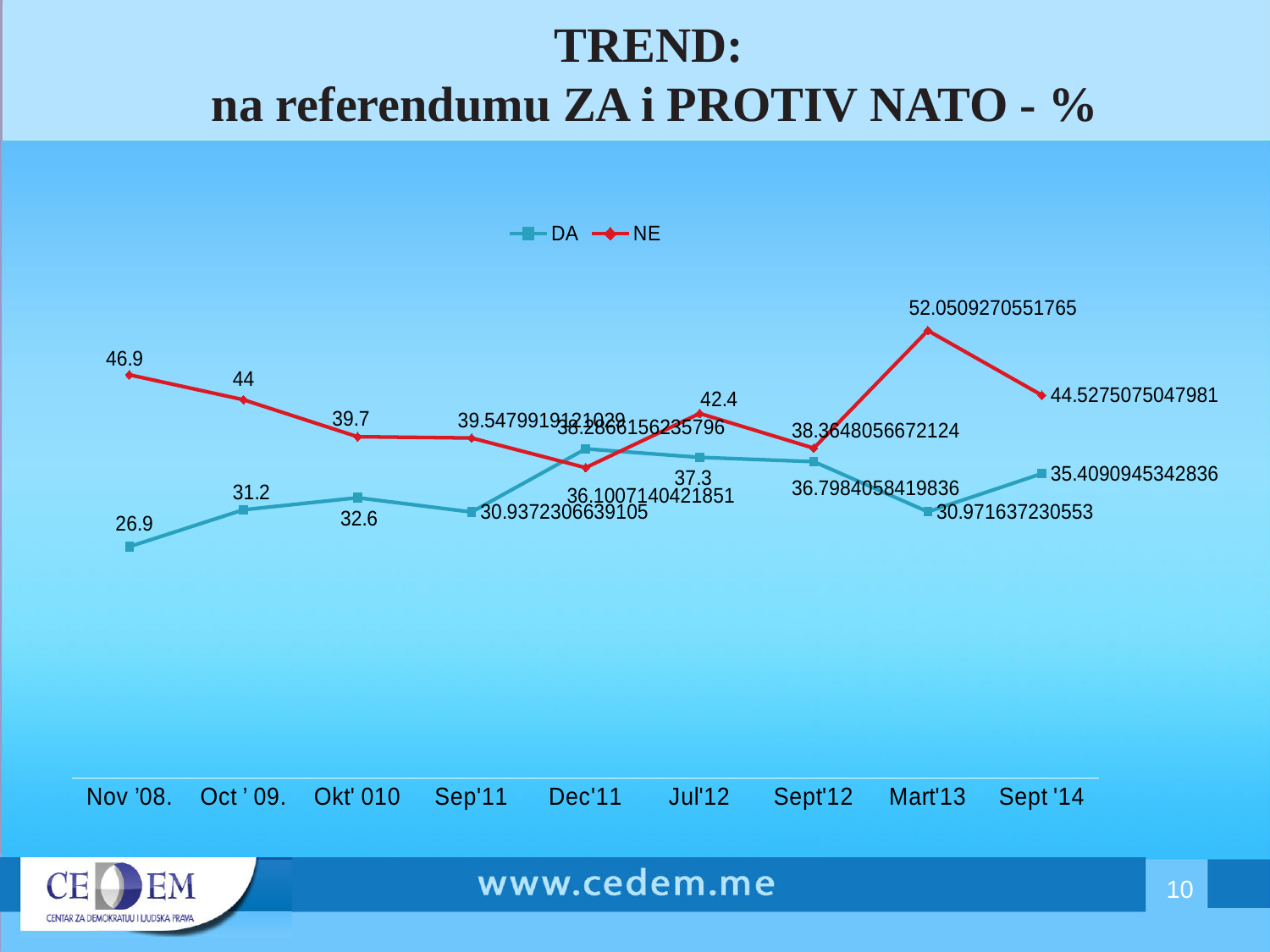
What is the value of NE at Nov '08.? 46.9 What is the value of DA at Sept '14? 35.4090945342836 How many series does the legend list? 2 What is the value of DA at Nov '08.? 26.9 At which time point is the DA series lowest? Nov '08. What is the value of NE at Mart'13? 52.0509270551765 What are the two series named in the legend? DA and NE How many time points are shown on the x axis? 9 What kind of chart is shown on the slide? line chart Which series has the larger value at Oct ' 09., DA or NE? NE At which time point is the NE series highest? Mart'13 What is the difference between NE and DA at Jul'12? 5.1